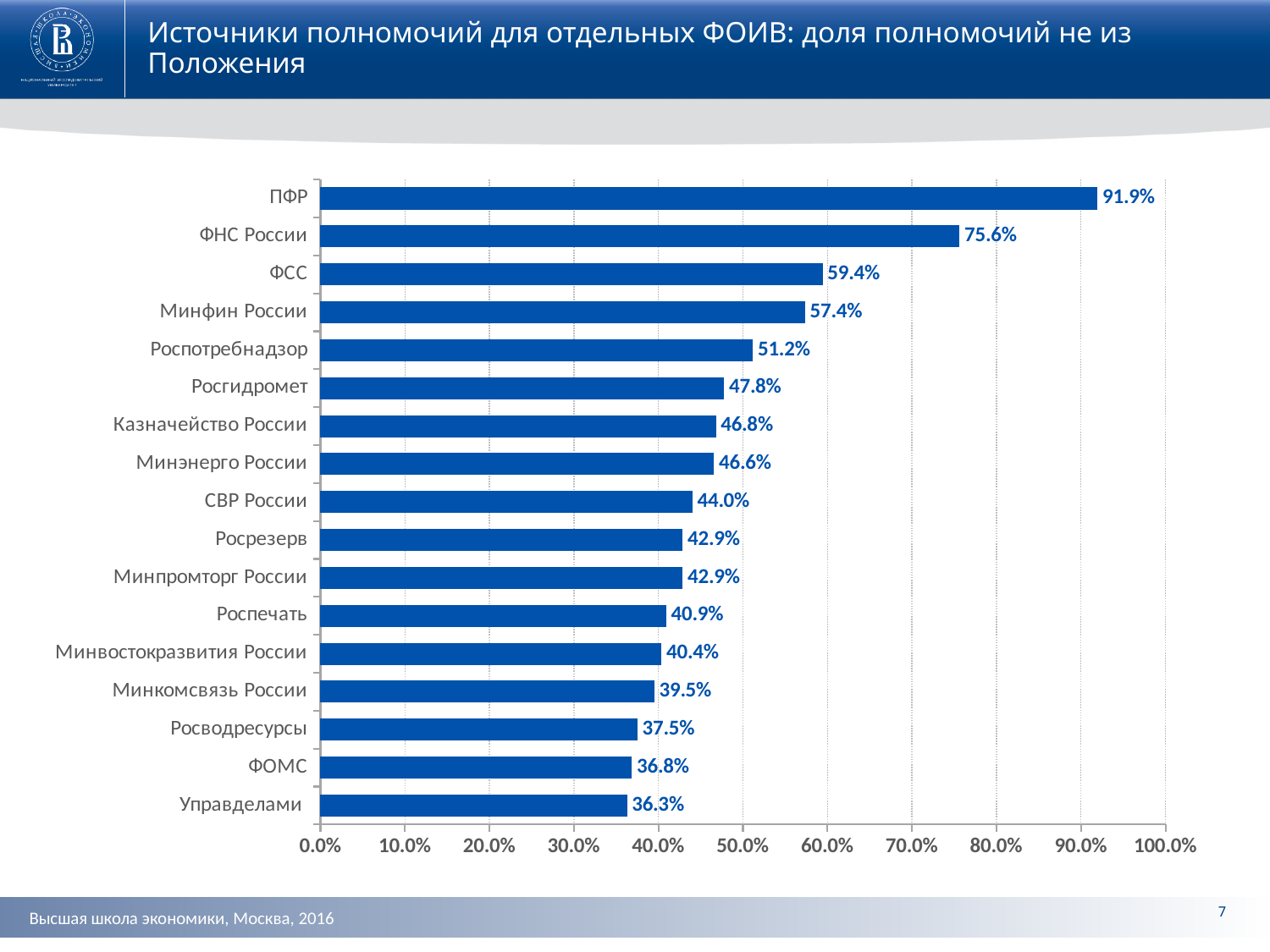
What is the difference between the values for ПФР and ФНС России? 16.3% Which category has the lowest value? Управделами What is the difference between the values for ФСС and ФОМС? 22.6% What is the value for Минфин России? 57.4% What is the value for Росводресурсы? 37.5% Which category has the highest value? ПФР Is the value for Минкомсвязь России greater or less than 40.0%? less What is the value for ПФР? 91.9% Which is larger, the value for Роспотребнадзор or the value for Росгидромет? Роспотребнадзор What kind of chart is shown on the slide? bar chart How many categories are shown in the chart? 17 What is the maximum value shown on the horizontal axis? 100.0%